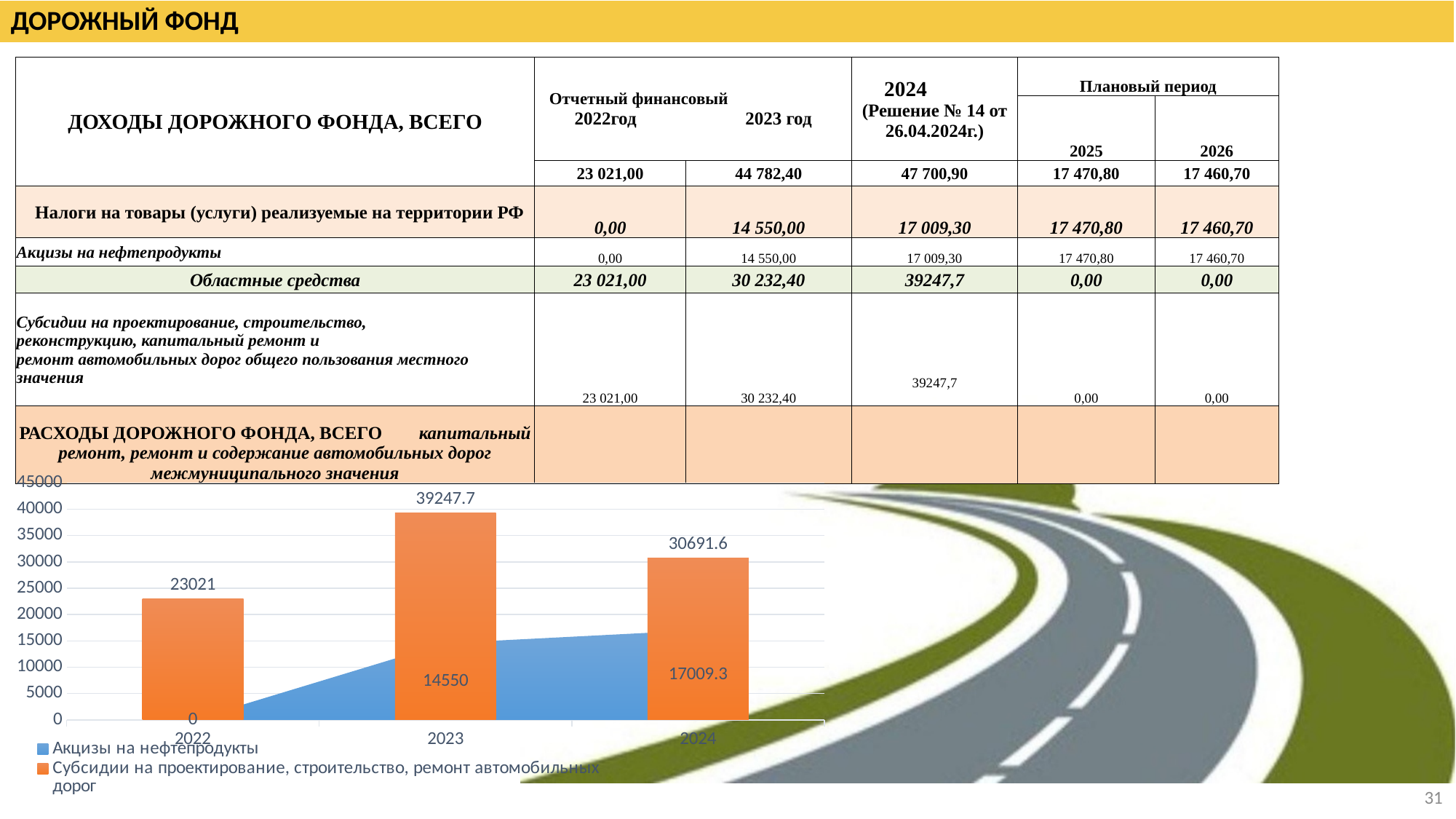
What is the value of the 'Субсидии на проектирование, строительство, ремонт автомобильных дорог' series for 2023? 39247.7 How many years are shown on the x axis of the chart? 3 Is the 'Субсидии' value for 2024 greater or less than 25000? greater What is the value of the 'Акцизы на нефтепродукты' series for 2024? 17009.3 What is the value of the 'Субсидии на проектирование, строительство, ремонт автомобильных дорог' series for 2022? 23021 How many series does the chart legend list? 2 Does the 'Акцизы на нефтепродукты' series rise or fall from 2022 to 2024? rise What is the difference between the 'Субсидии' values for 2023 and 2024? 8556.1 Which is larger in 2024: 'Акцизы на нефтепродукты' or 'Субсидии на проектирование, строительство, ремонт автомобильных дорог'? Субсидии на проектирование, строительство, ремонт автомобильных дорог What is the value of the 'Акцизы на нефтепродукты' series for 2022? 0 In which year is the 'Субсидии на проектирование, строительство, ремонт автомобильных дорог' series highest? 2023 In which year is the 'Акцизы на нефтепродукты' series lowest? 2022